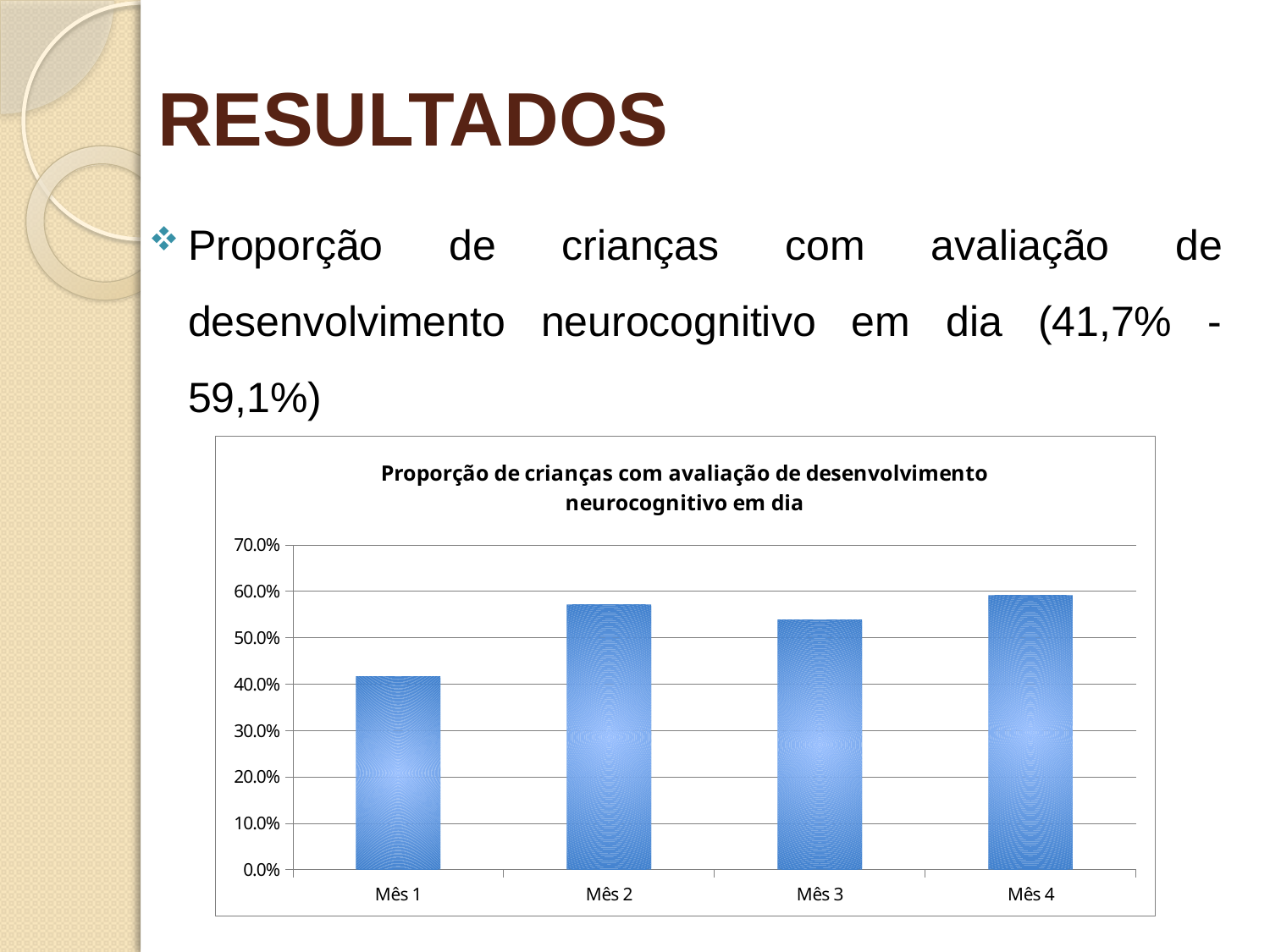
Overall, do the values rise or fall from Mês 1 to Mês 4? rise Is the value for Mês 3 greater or less than 60.0%? less Which is larger, the value for Mês 2 or the value for Mês 3? Mês 2 Is the value for Mês 1 greater or less than 50.0%? less Is the value for Mês 2 greater or less than 50.0%? greater Which is larger, the value for Mês 1 or the value for Mês 3? Mês 3 How many categories (months) are shown on the x axis of the chart? 4 Which is larger, the value for Mês 1 or the value for Mês 4? Mês 4 What kind of chart is shown on the slide? bar chart Which month has the lowest proportion in the chart? Mês 1 What is the title of the chart? Proporção de crianças com avaliação de desenvolvimento neurocognitivo em dia